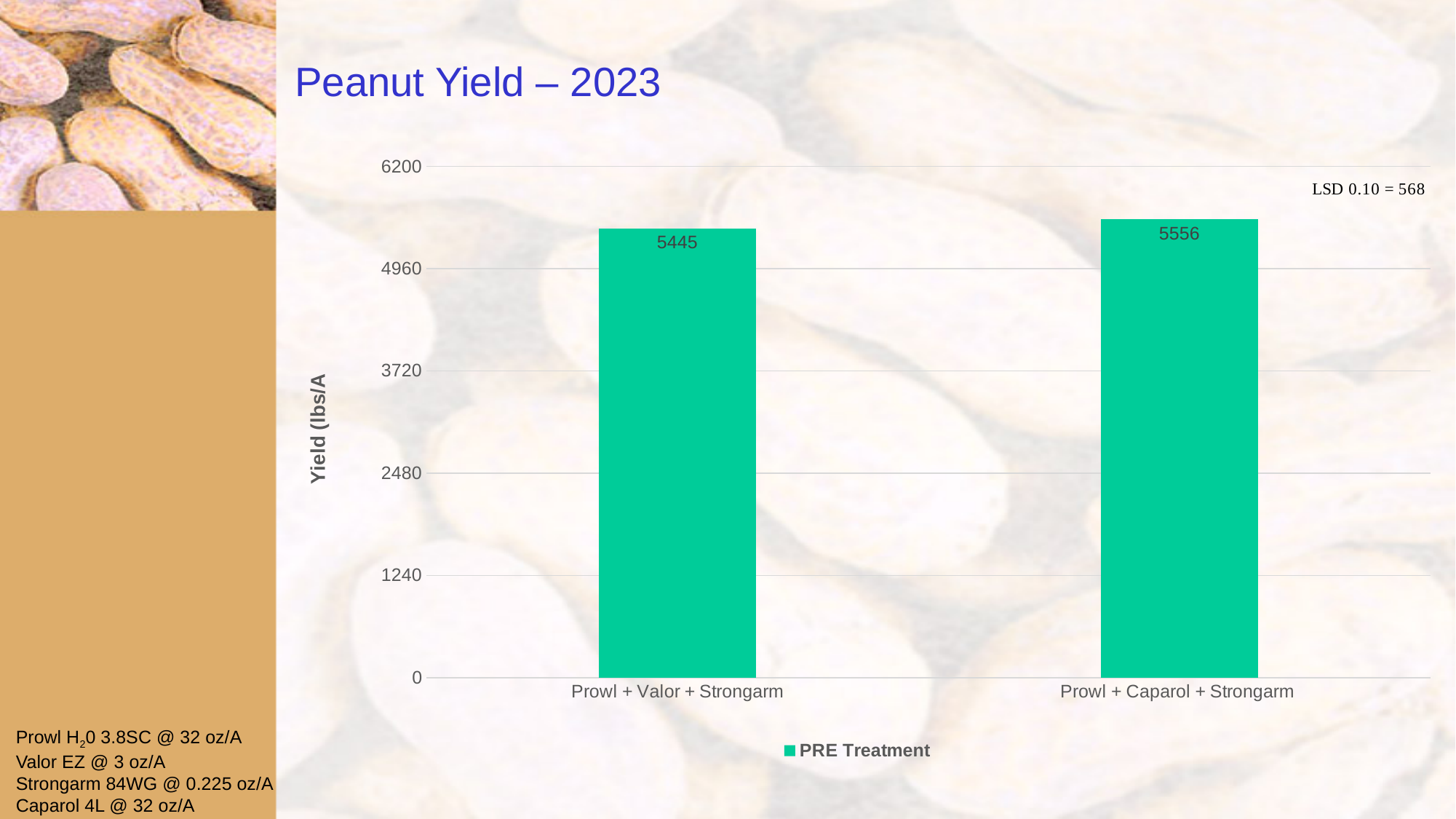
What is the title of the chart? Peanut Yield – 2023 What kind of chart is shown on the slide? bar chart Is the yield for Prowl + Valor + Strongarm greater or less than 4960? greater How many series does the legend list? 1 What is the yield for Prowl + Caparol + Strongarm? 5556 How many treatments are shown on the chart? 2 Which treatment has the highest yield? Prowl + Caparol + Strongarm Which has a larger yield, Prowl + Valor + Strongarm or Prowl + Caparol + Strongarm? Prowl + Caparol + Strongarm What is the yield for Prowl + Valor + Strongarm? 5445 Which treatment has the lowest yield? Prowl + Valor + Strongarm What is the difference in yield between Prowl + Caparol + Strongarm and Prowl + Valor + Strongarm? 111 Is the yield for Prowl + Caparol + Strongarm greater or less than 6200? less